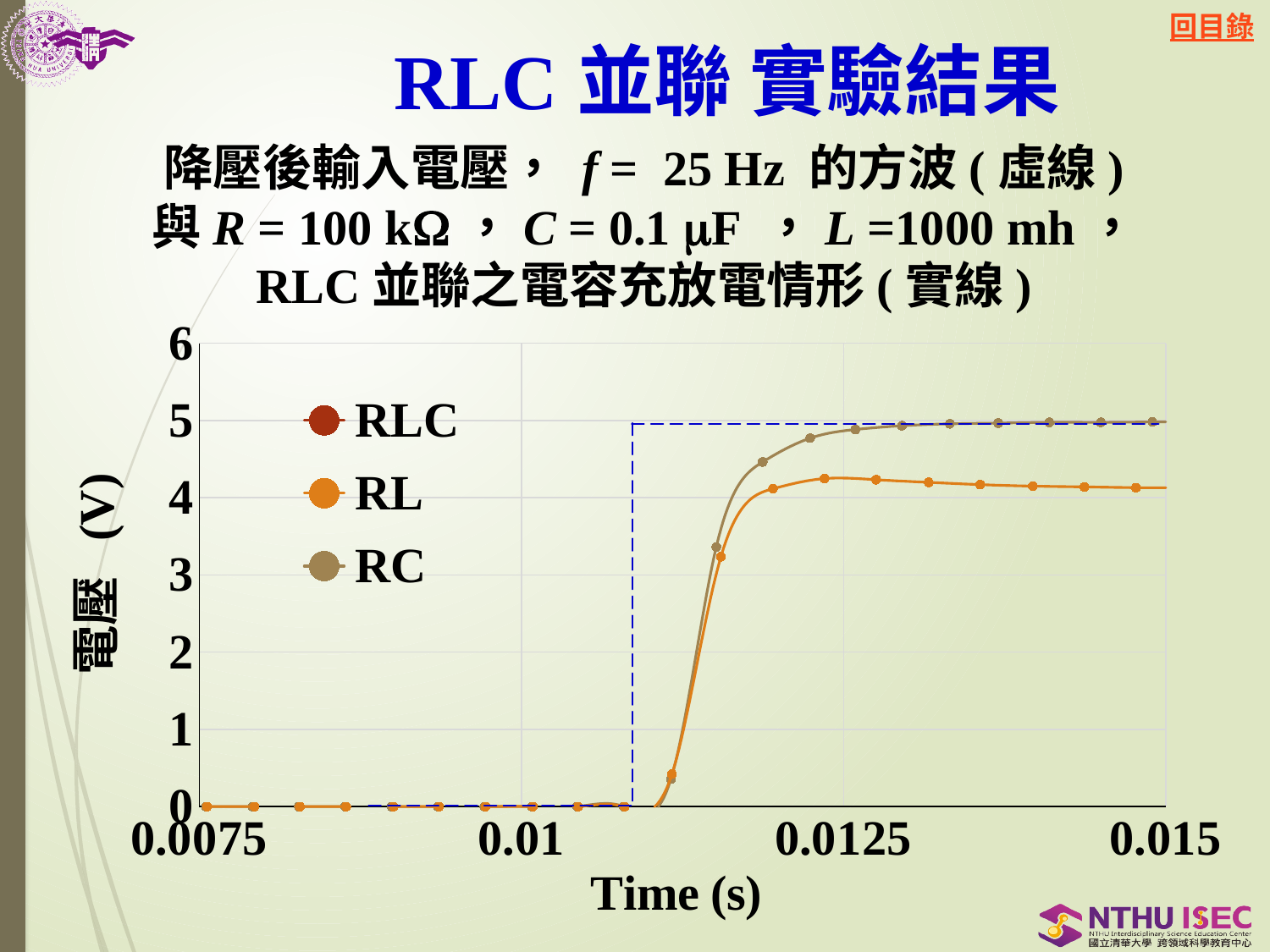
What kind of chart is shown on the slide? line chart Is the value of the RL series at time 0.0125 s greater or less than 3? greater What voltage level does the dashed square-wave input reach after it steps up? 5 What are the three series named in the legend? RLC, RL, RC At time 0.015 s, which series has the larger value, RC or RL? RC Is the value of the RC series at time 0.015 s greater or less than 4? greater Is the value of the RL series at time 0.015 s greater or less than 5? less What is the value of the RL series at time 0.01 s? 0 How many series does the legend list? 3 Do the solid-line voltage values rise or fall as time increases from 0.0075 s to 0.015 s? rise What is the label of the x axis? Time (s)